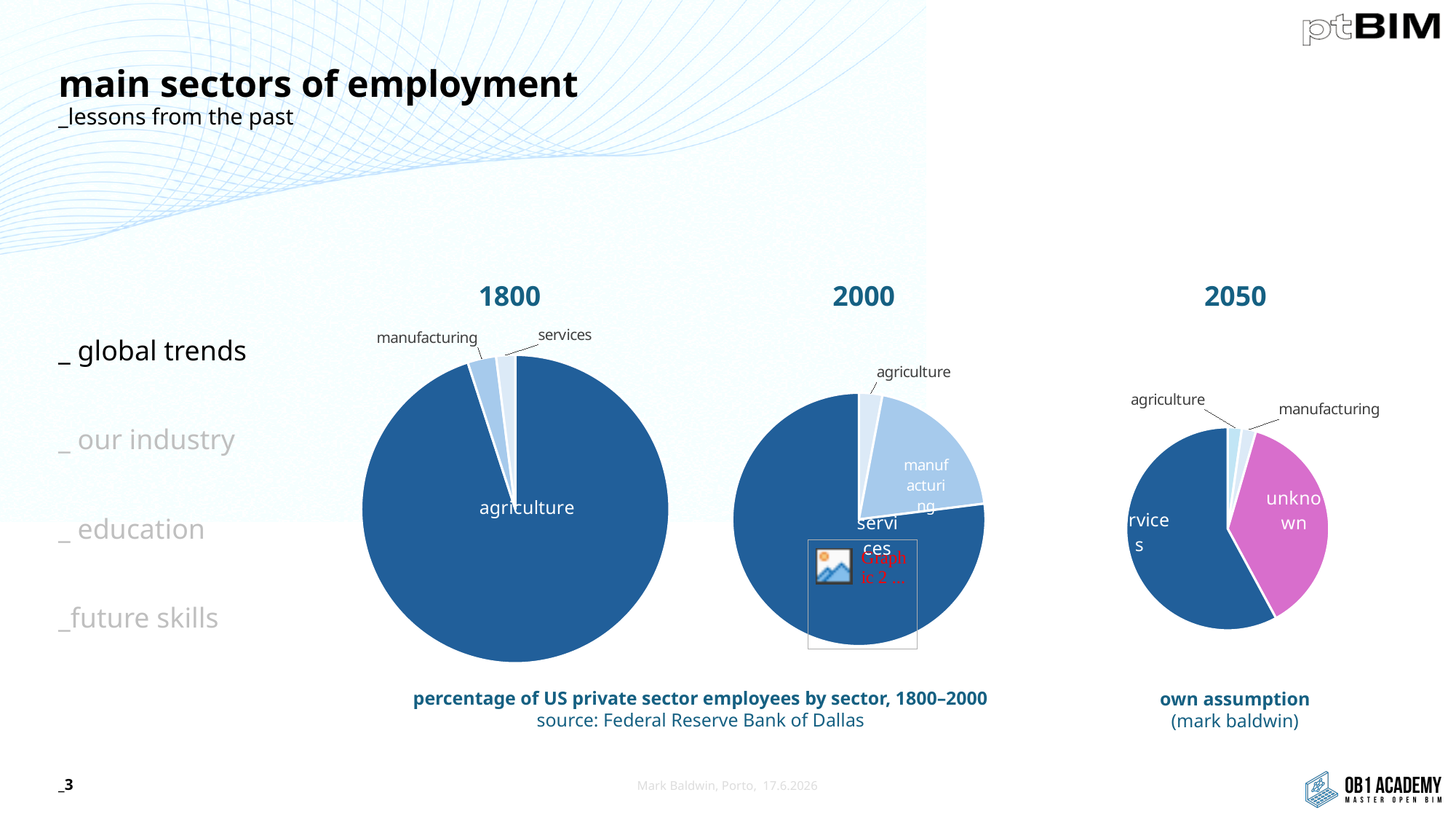
In the 2000 pie chart, which sector has the largest slice? services What is the source given for the 1800 and 2000 pie charts? Federal Reserve Bank of Dallas What is the caption below the 1800 and 2000 pie charts? percentage of US private sector employees by sector, 1800–2000 In the 2050 pie chart, which slice is larger, unknown or manufacturing? unknown In the 2050 pie chart, which sector has the largest slice? services How many slices does the 2050 pie chart have? 4 In the 1800 pie chart, which sector has the largest slice? agriculture In the 2000 pie chart, which slice is larger, manufacturing or agriculture? manufacturing In the 1800 pie chart, which sector has the smallest slice? services What kind of chart is the 1800 chart? pie chart How many slices does the 1800 pie chart have? 3 In the 2000 pie chart, which sector has the smallest slice? agriculture